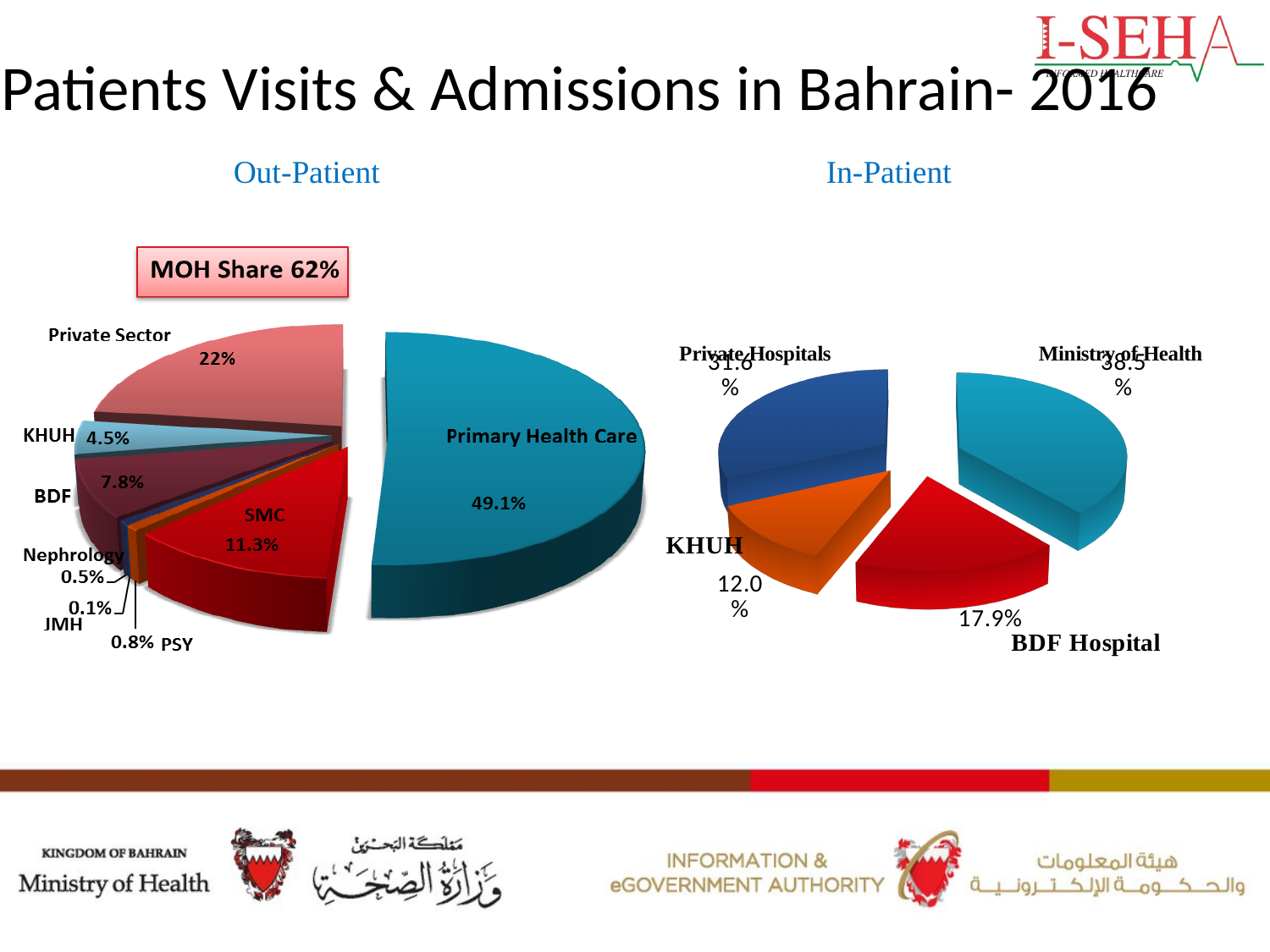
On the In-Patient pie chart, which is larger, Private Hospitals or KHUH? Private Hospitals On the Out-Patient pie chart, what share is shown for the Private Sector? 22% On the In-Patient pie chart, what share is shown for BDF Hospital? 17.9% On the Out-Patient pie chart, how many categories are shown? 8 On the In-Patient pie chart, which category has the largest share? Ministry of Health On the Out-Patient pie chart, which category has the largest share? Primary Health Care On the Out-Patient pie chart, what share is shown for SMC? 11.3% On the In-Patient pie chart, what is the difference between the Ministry of Health share and the Private Hospitals share? 6.9% On the Out-Patient pie chart, what is the difference between the BDF share and the KHUH share? 3.3% On the Out-Patient pie chart, which category has the smallest share? JMH What MOH share is stated in the box above the Out-Patient chart? 62% On the Out-Patient pie chart, what share is shown for Primary Health Care? 49.1%